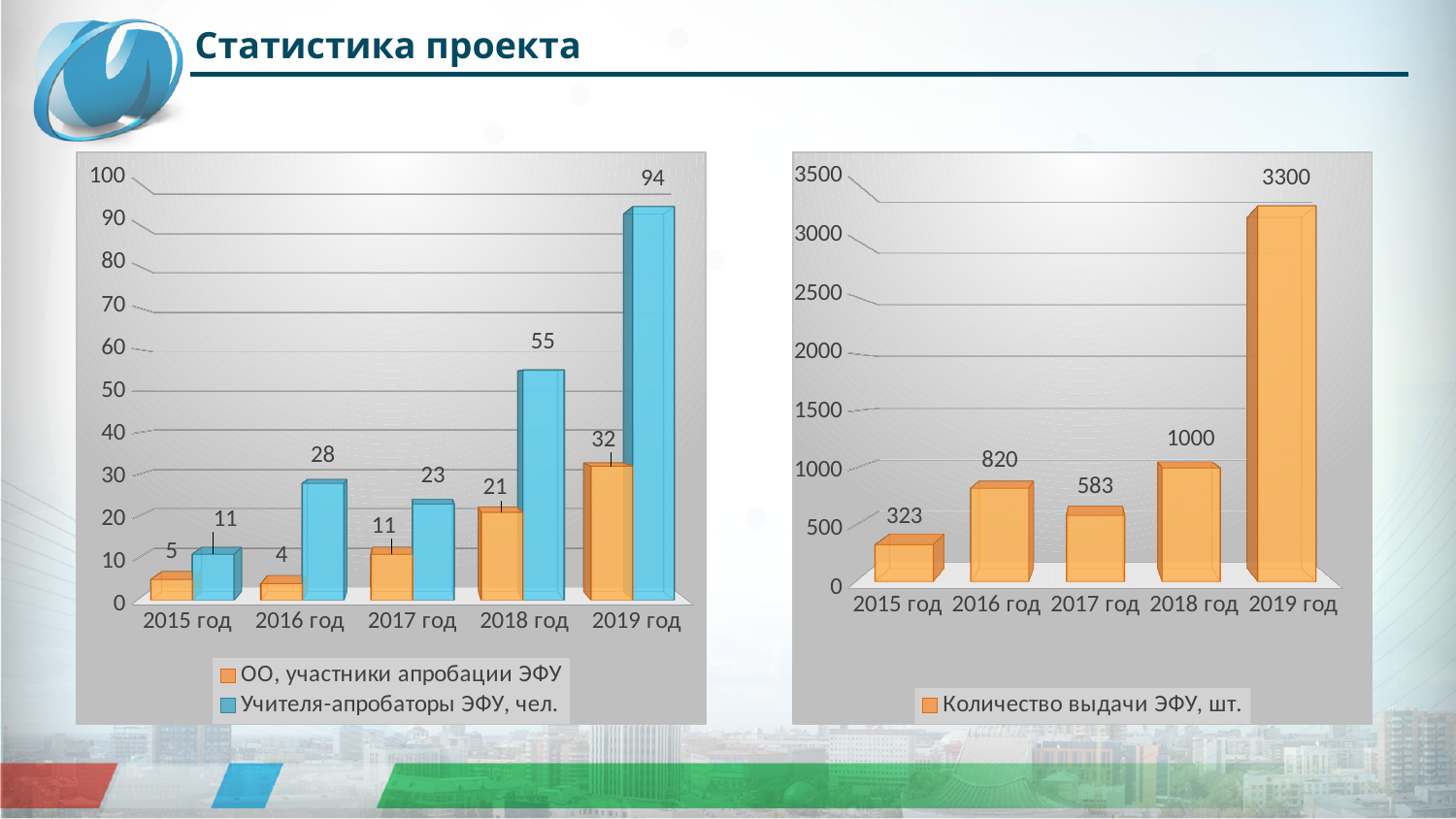
In the left chart, which year has the lowest value for ОО, участники апробации ЭФУ? 2016 год In the left chart, what is the difference between Учителя-апробаторы ЭФУ, чел. and ОО, участники апробации ЭФУ in 2018 год? 34 In the right chart, what is the difference between the values for 2019 год and 2018 год? 2300 In the right chart, what is the value for Количество выдачи ЭФУ, шт. in 2016 год? 820 What kind of chart is the right chart? bar chart How many years are shown on the x axis of the right chart? 5 In the left chart, which is larger for Учителя-апробаторы ЭФУ, чел.: 2016 год or 2017 год? 2016 год In the right chart, is the value for 2017 год greater or less than 500? greater How many series does the legend of the left chart list? 2 In the left chart, what is the value for ОО, участники апробации ЭФУ in 2017 год? 11 In the right chart, which year has the highest value? 2019 год In the left chart, what is the value for Учителя-апробаторы ЭФУ, чел. in 2019 год? 94